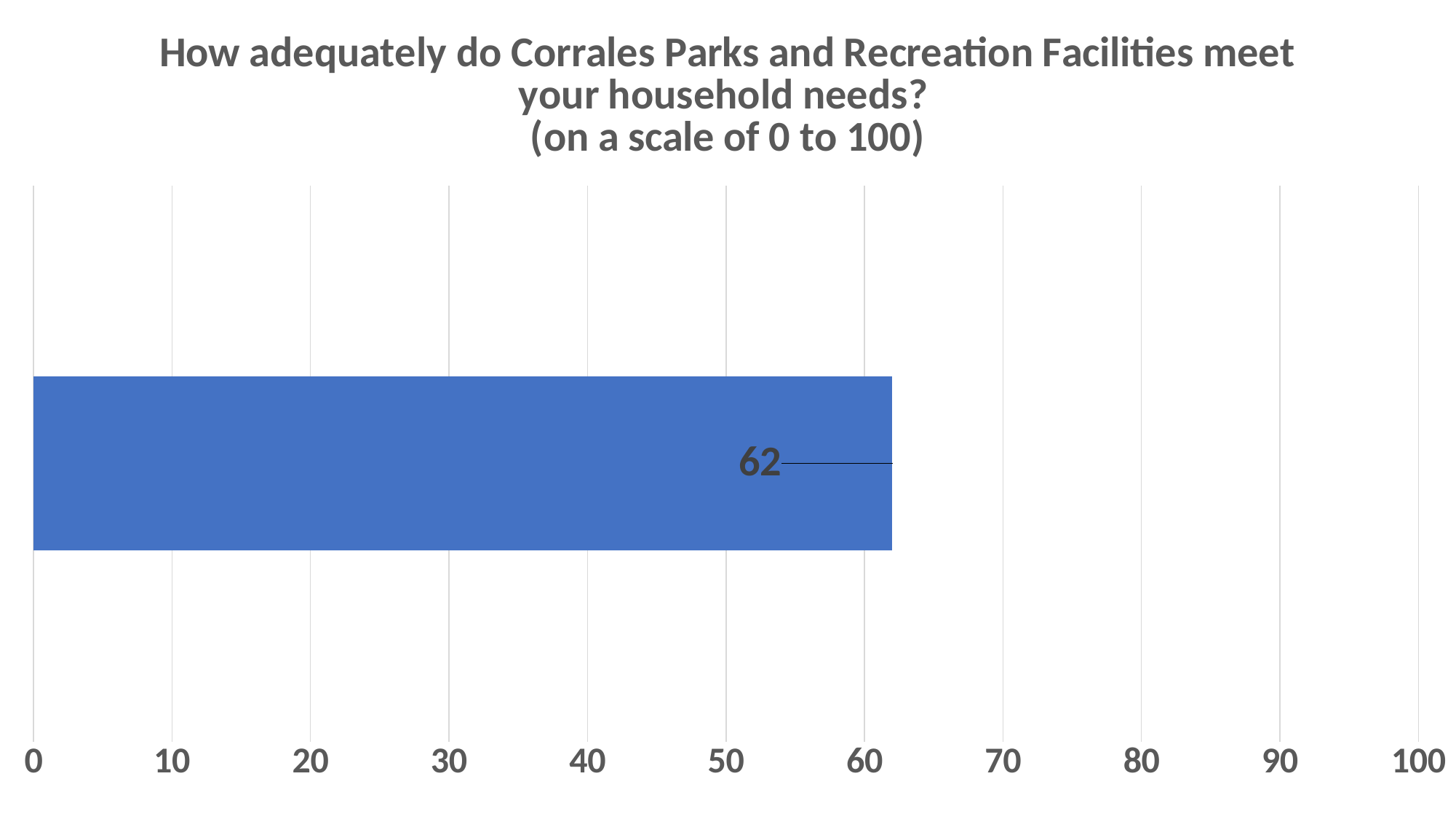
What kind of chart is shown on the slide? bar chart What scale does the chart title say the rating is on? 0 to 100 Is the value shown by the bar greater or less than 50? greater What value is shown by the bar on the chart? 62 How many bars are plotted on the chart? 1 Is the value shown by the bar greater or less than 70? less How far below 100 is the plotted value of 62? 38 What is the maximum value shown on the horizontal axis? 100